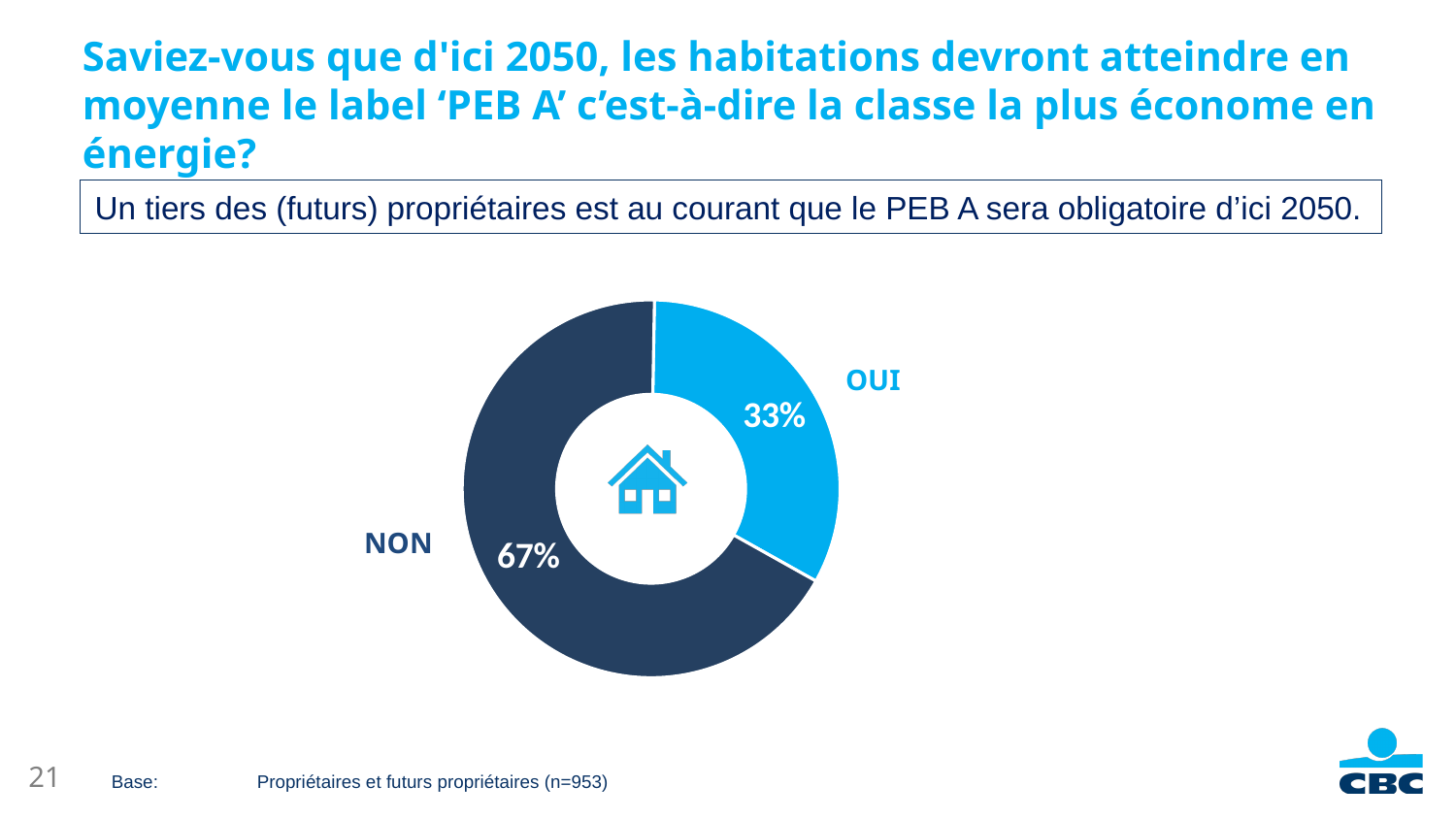
What kind of chart is shown on the slide? Pie chart (doughnut) What share of the chart does the OUI slice represent? 33% Which is larger, the share for OUI or the share for NON? NON What is the difference in percentage points between NON and OUI? 34 What is the base (sample size) stated for the chart? n=953 Which answer has the largest share of the chart? NON What colour is the OUI slice? Light blue Which answer has the smallest share of the chart? OUI How many categories are shown in the chart? 2 What percentage of respondents answered NON? 67% What percentage of respondents answered OUI? 33%